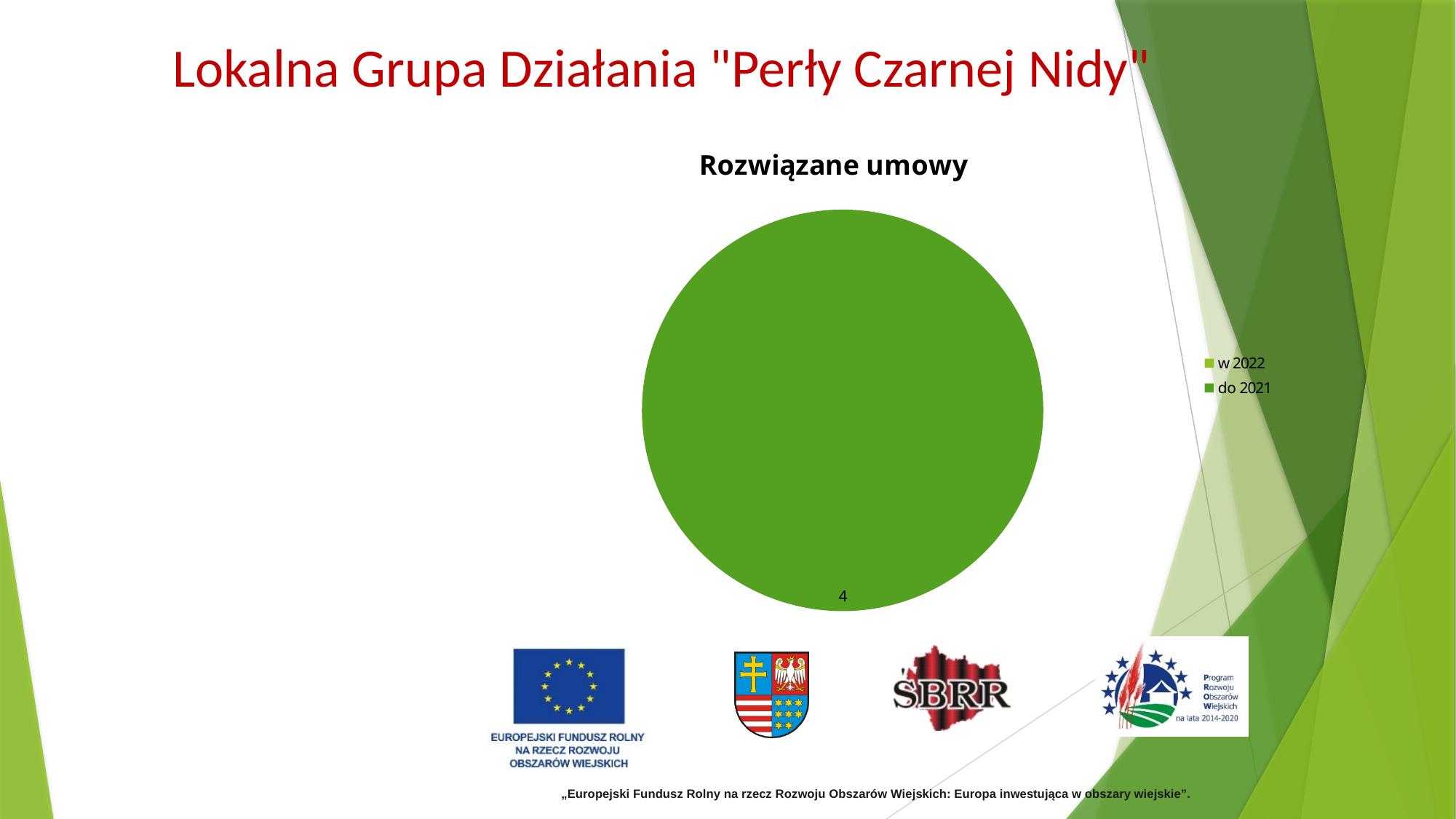
What kind of chart is shown on the slide? pie chart How many entries does the chart legend list? 2 What data label value is printed on the pie chart? 4 Which category has the largest slice in the pie chart? do 2021 Which legend entry's colour fills the visible pie? do 2021 What is the value shown for "do 2021" in the pie chart? 4 What is the title of the chart? Rozwiązane umowy